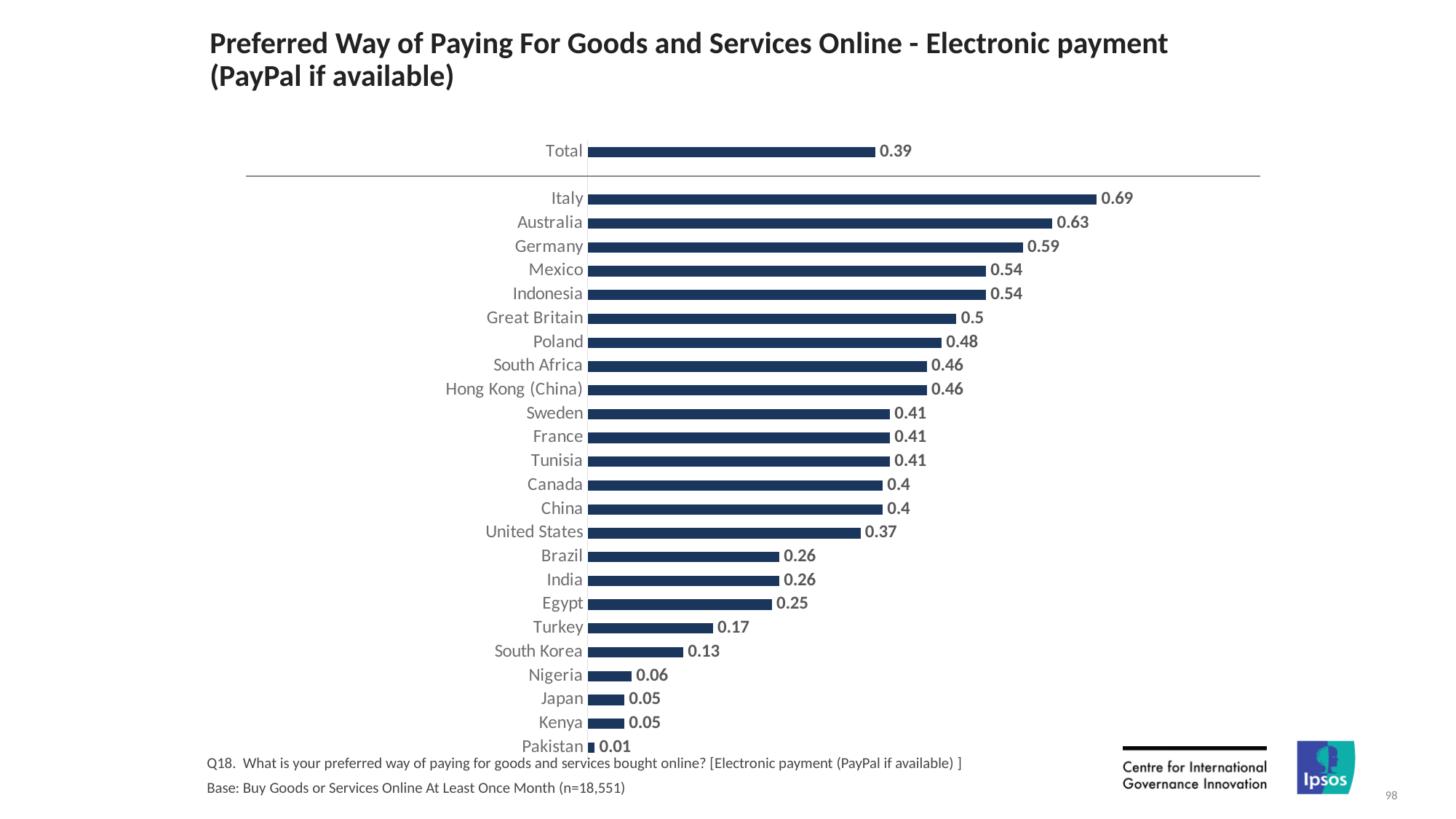
Which country has the lowest value? Pakistan Which country has the highest value? Italy Which has a larger value, Poland or Brazil? Poland Which has a larger value, Turkey or Egypt? Egypt What is the value for Italy? 0.69 What is the difference between the values for Italy and Australia? 0.06 What is the value for Hong Kong (China)? 0.46 What is the value for South Korea? 0.13 What is the value for the Total bar? 0.39 What is the difference between the values for Germany and the United States? 0.22 What kind of chart is shown on the slide? Bar chart How many countries are listed below the Total bar? 24